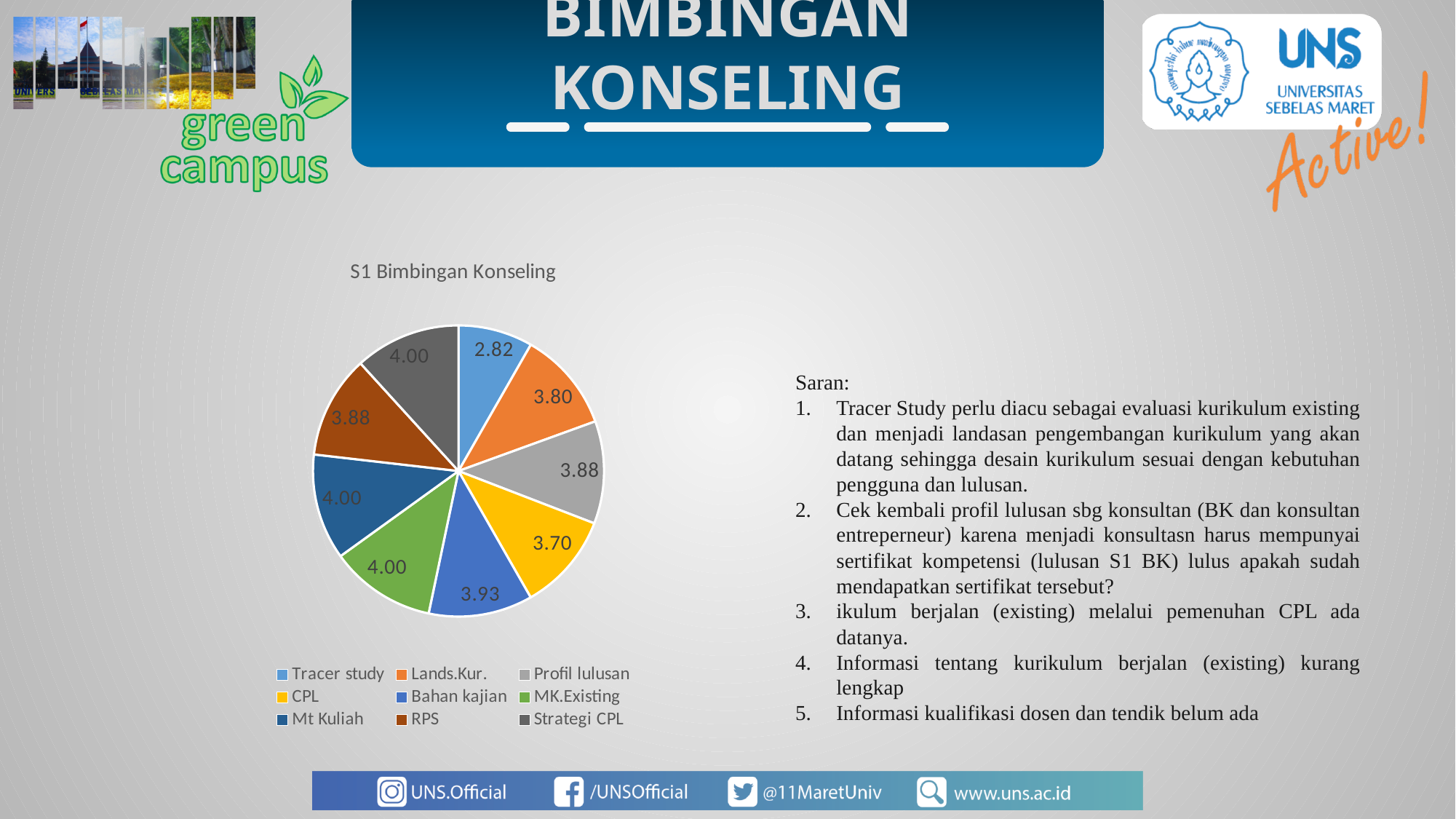
Which is larger, the value for Bahan kajian or the value for CPL? Bahan kajian How many categories does the pie chart have? 9 What is the value for Bahan kajian? 3.93 What is the value for Lands.Kur.? 3.80 What is the value for Tracer study? 2.82 What is the value for CPL? 3.70 What is the title of the chart? S1 Bimbingan Konseling What is the difference between the values for Bahan kajian and Tracer study? 1.11 What is the value for RPS? 3.88 What kind of chart is shown on the slide? pie chart What colour is the slice for MK.Existing? green Which category has the lowest value? Tracer study